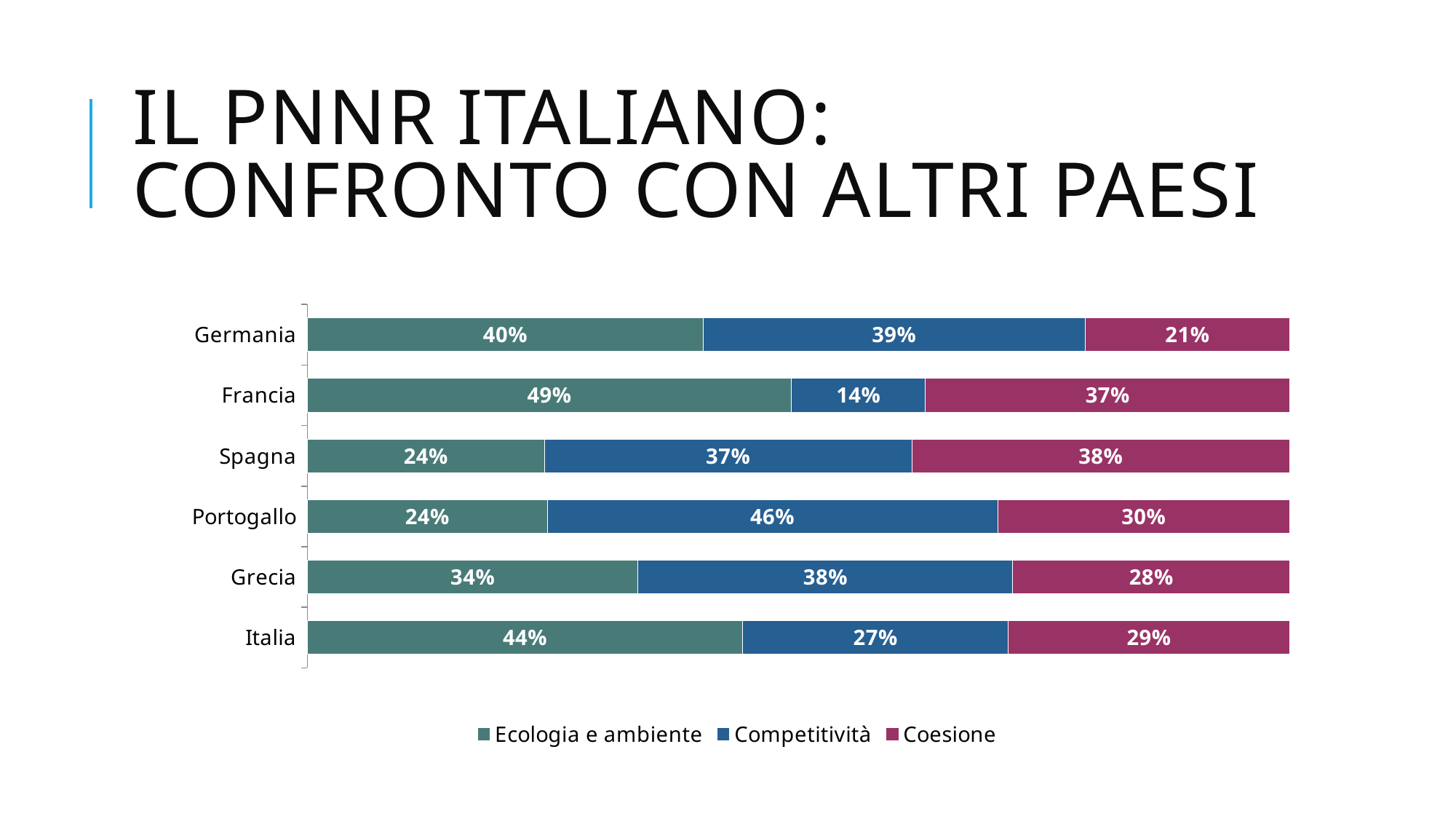
What is the Competitività value for Portogallo? 46% Which is larger, the Competitività value for Spagna or for Grecia? Grecia Which country has the highest Ecologia e ambiente value? Francia What is the Competitività value for Italia? 27% Which country has the lowest Competitività value? Francia How many series does the legend list? 3 How many countries are shown in the chart? 6 What is the difference between the Ecologia e ambiente values for Italia and Grecia? 10% What is the Ecologia e ambiente value for Francia? 49% Which country has the highest Coesione value? Spagna What kind of chart is shown on the slide? Stacked bar chart What is the Coesione value for Germania? 21%